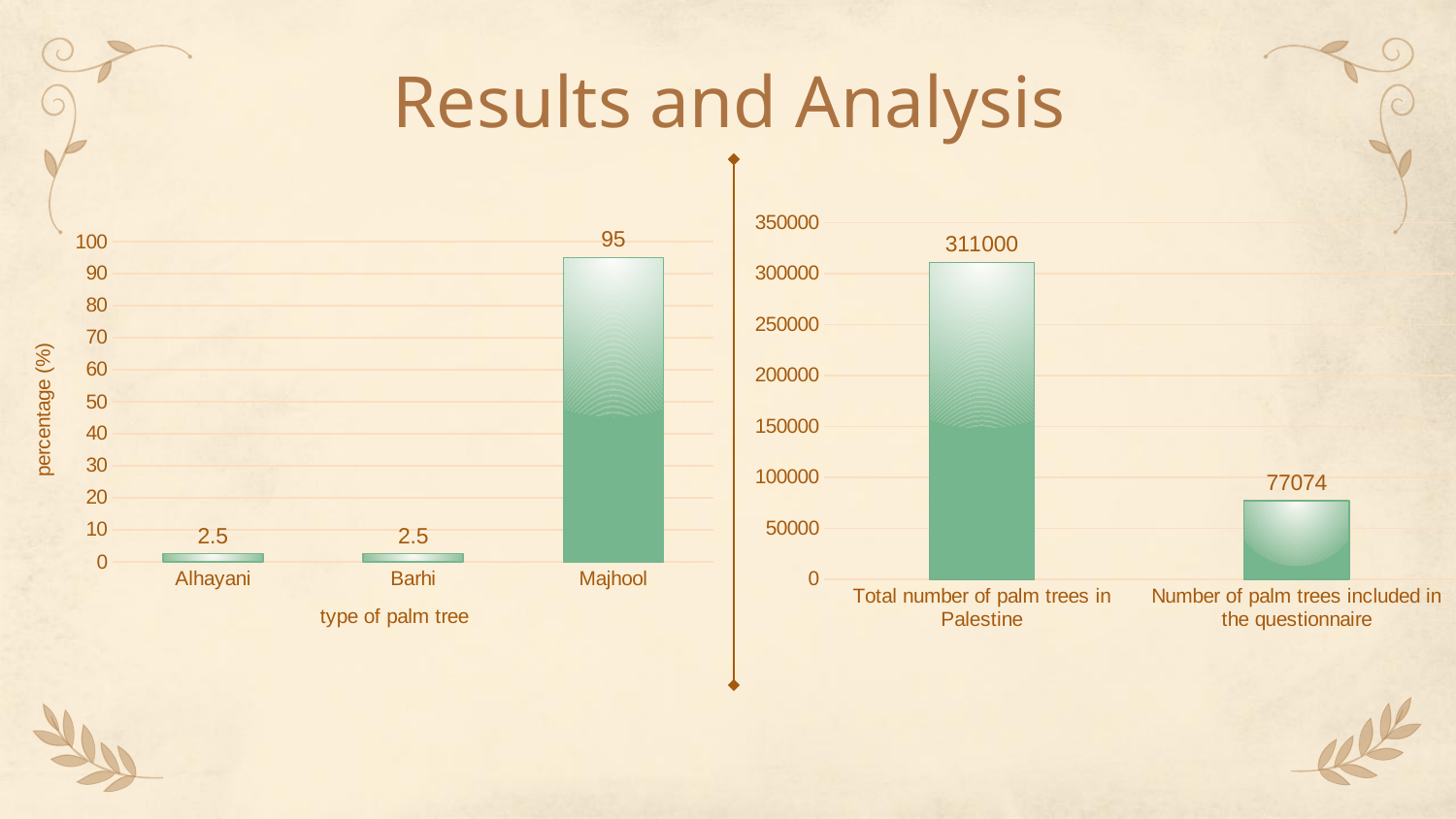
In the left chart, what is the percentage for Majhool? 95 In the left chart, what is the percentage for Alhayani? 2.5 In the left chart, which type of palm tree has the highest percentage? Majhool In the right chart, what is the difference between the total number of palm trees in Palestine and the number included in the questionnaire? 233926 In the right chart, which is larger: the total number of palm trees in Palestine or the number included in the questionnaire? Total number of palm trees in Palestine In the left chart, what is the difference between the percentages for Majhool and Barhi? 92.5 In the left chart, how many types of palm tree are shown on the x axis? 3 In the right chart, what is the number of palm trees included in the questionnaire? 77074 In the left chart, what is the label of the y axis? percentage (%) In the right chart, what is the total number of palm trees in Palestine? 311000 What kind of chart is the right chart? bar chart In the right chart, is the value for the number of palm trees included in the questionnaire greater or less than 100000? less